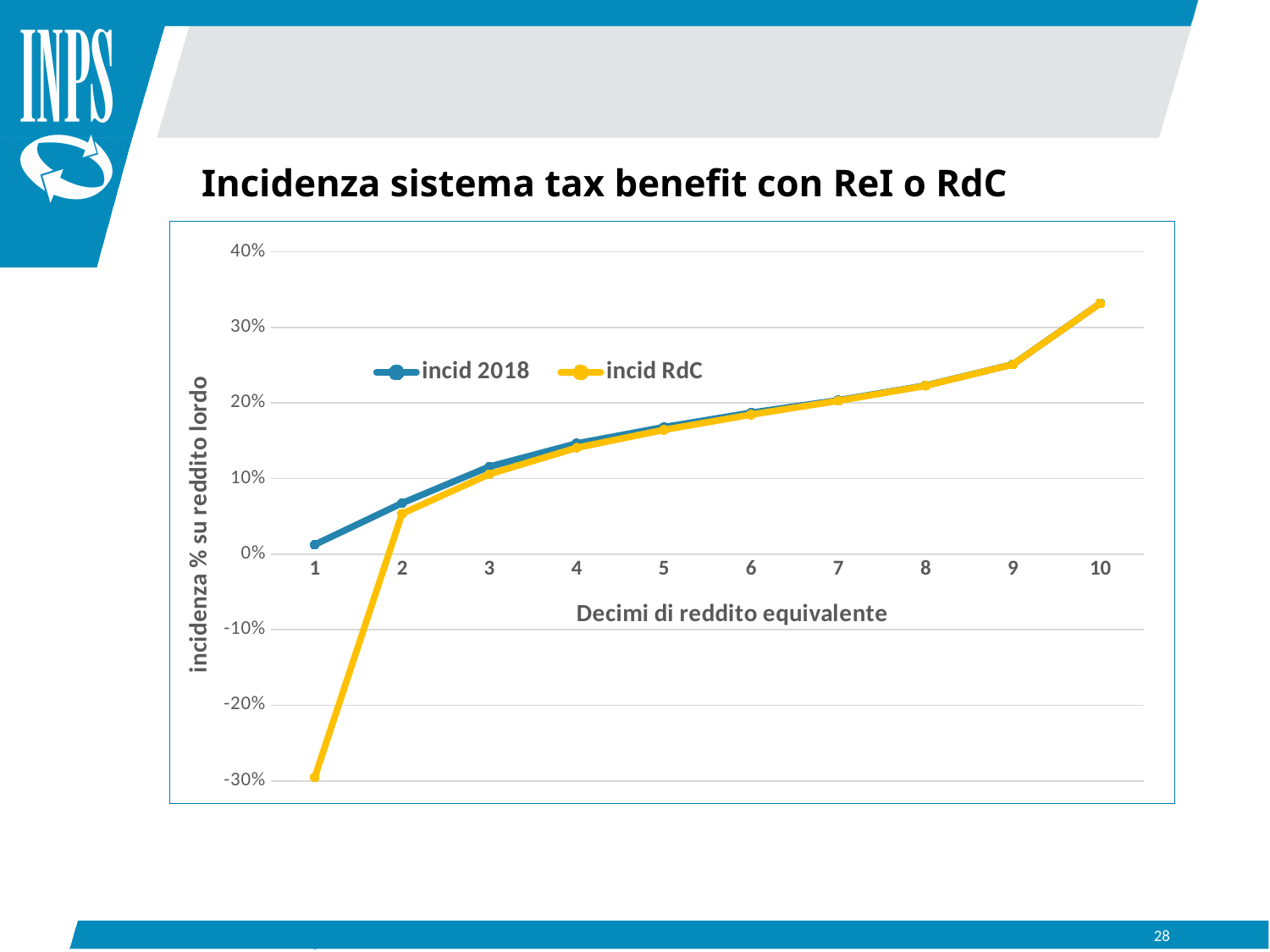
Is the value of incid 2018 at decile 5 greater or less than 10%? greater Is the value of incid 2018 at decile 2 greater or less than 10%? less Is the value of incid RdC at decile 10 greater or less than 30%? greater How many deciles are plotted along the x axis? 10 At which decile is incid RdC lowest? 1 What kind of chart is shown on the slide? line chart At decile 1, which series has the larger value, incid 2018 or incid RdC? incid 2018 At which decile is incid 2018 highest? 10 Which series is shown in yellow? incid RdC What is the title of the chart? Incidenza sistema tax benefit con ReI o RdC How many series does the legend list? 2